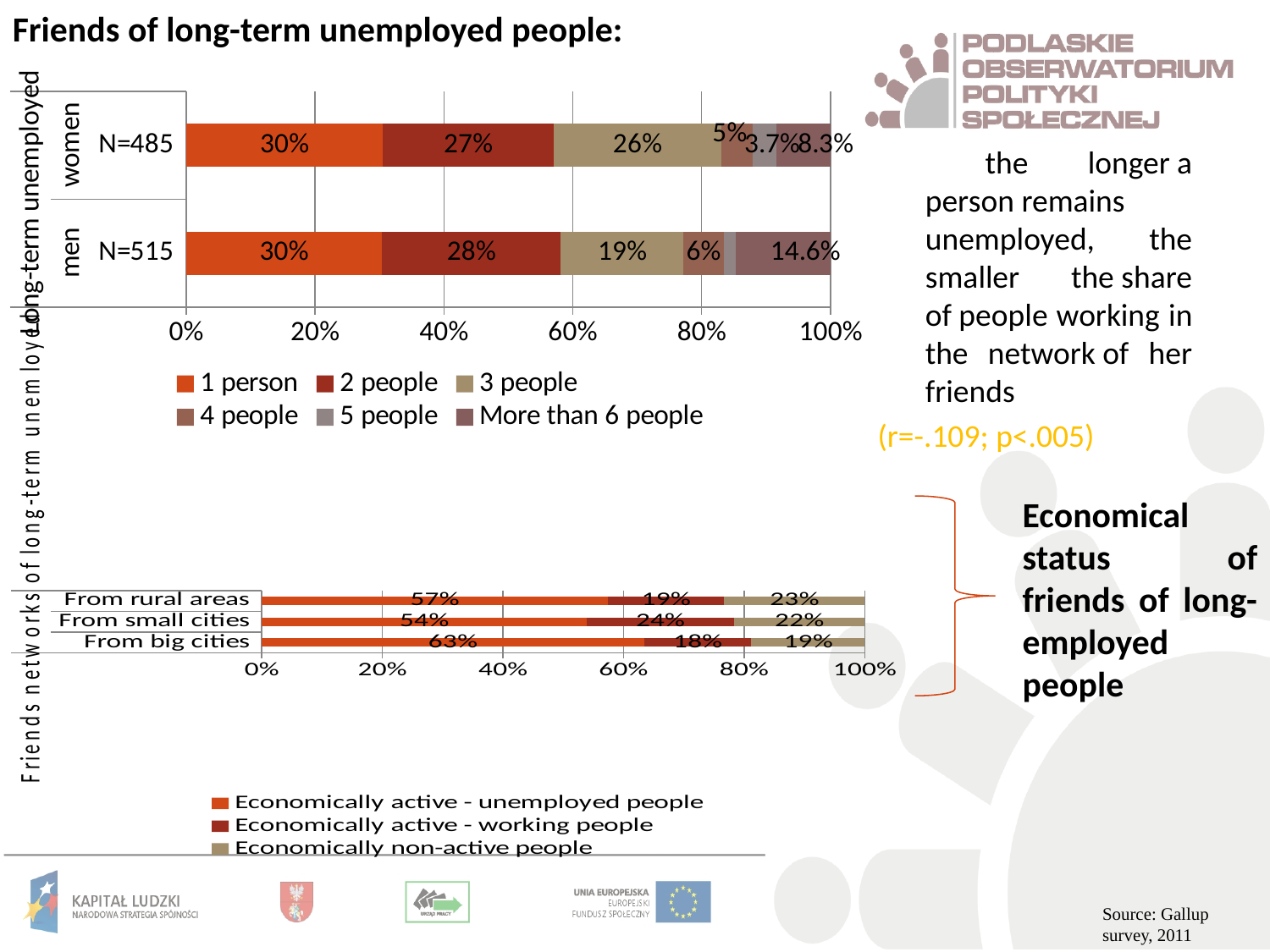
In the top chart, how many series does the legend list? 6 In the top chart, what share of women have 5 people in their friends network? 3.7% In the top chart, what share of men have more than 6 people in their friends network? 14.6% In the bottom chart, which category has the highest share of economically active - unemployed people? From big cities In the top chart, what share of men have 3 people in their friends network? 19% In the bottom chart, how many categories are shown? 3 In the top chart, what share of women have 1 person in their friends network? 30% In the top chart, what is the difference between the women's and men's shares for 3 people? 7% What type of chart is the bottom chart? Stacked bar chart In the bottom chart, what share of friends from small cities are economically active - working people? 24% In the bottom chart, what share of friends from big cities are economically active - unemployed people? 63% In the top chart, which group has the larger share for 3 people, women or men? women